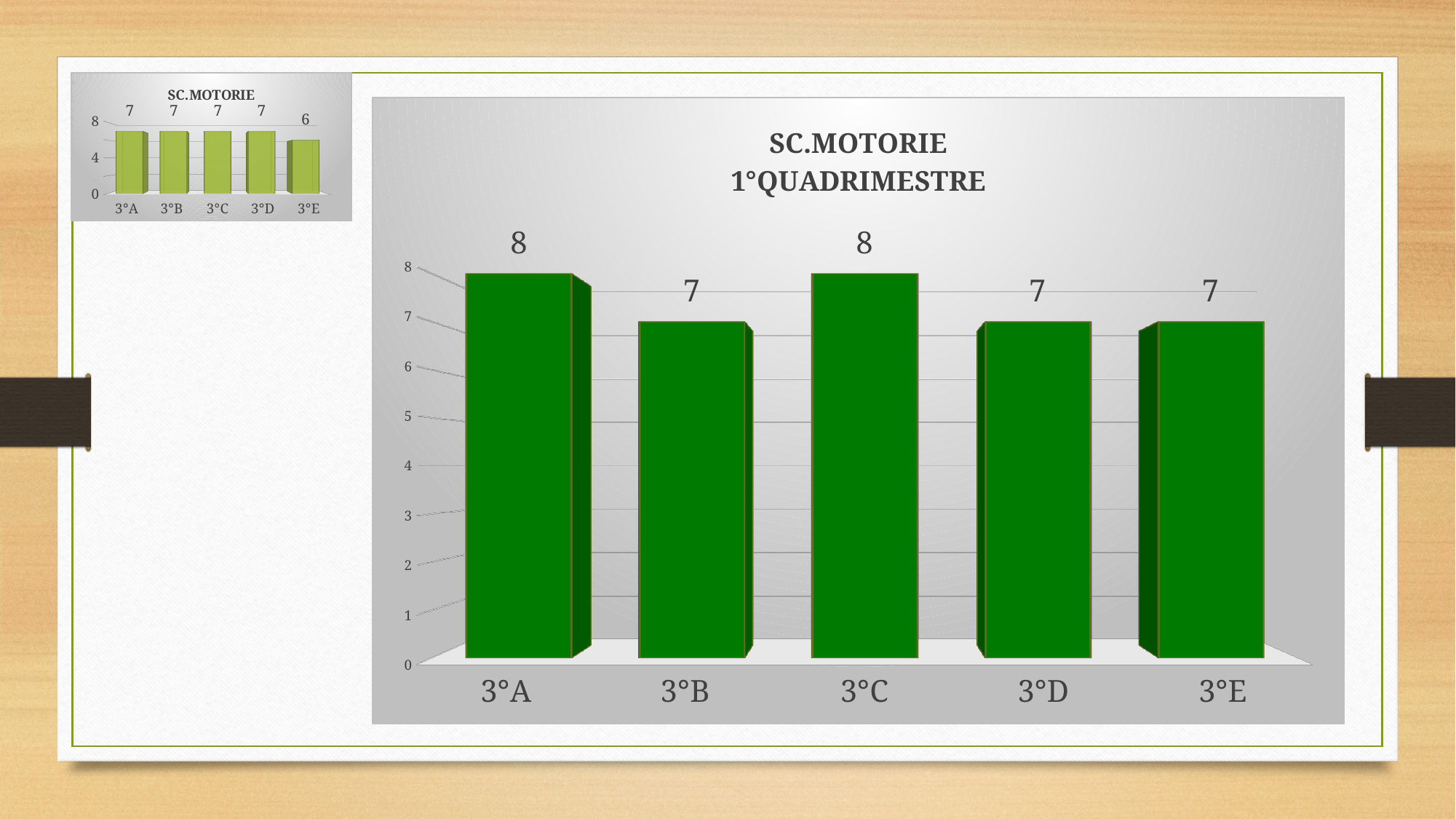
In the large chart titled SC.MOTORIE 1°QUADRIMESTRE, which categories have the highest value? 3°A and 3°C In the small chart at the top left titled SC.MOTORIE, which category has the lowest value? 3°E In the large chart titled SC.MOTORIE 1°QUADRIMESTRE, what is the value for 3°A? 8 In the large chart titled SC.MOTORIE 1°QUADRIMESTRE, what is the difference between the values for 3°C and 3°D? 1 In the large chart titled SC.MOTORIE 1°QUADRIMESTRE, what is the value for 3°E? 7 In the small chart at the top left titled SC.MOTORIE, what is the value for 3°A? 7 In the large chart titled SC.MOTORIE 1°QUADRIMESTRE, how many categories are shown on the x axis? 5 In the small chart at the top left titled SC.MOTORIE, what is the value for 3°E? 6 What kind of chart is the large chart titled SC.MOTORIE 1°QUADRIMESTRE? Bar chart What is the title of the large chart on the slide? SC.MOTORIE 1°QUADRIMESTRE In the large chart titled SC.MOTORIE 1°QUADRIMESTRE, what is the value for 3°B? 7 In the large chart titled SC.MOTORIE 1°QUADRIMESTRE, which is larger, the value for 3°A or the value for 3°B? 3°A